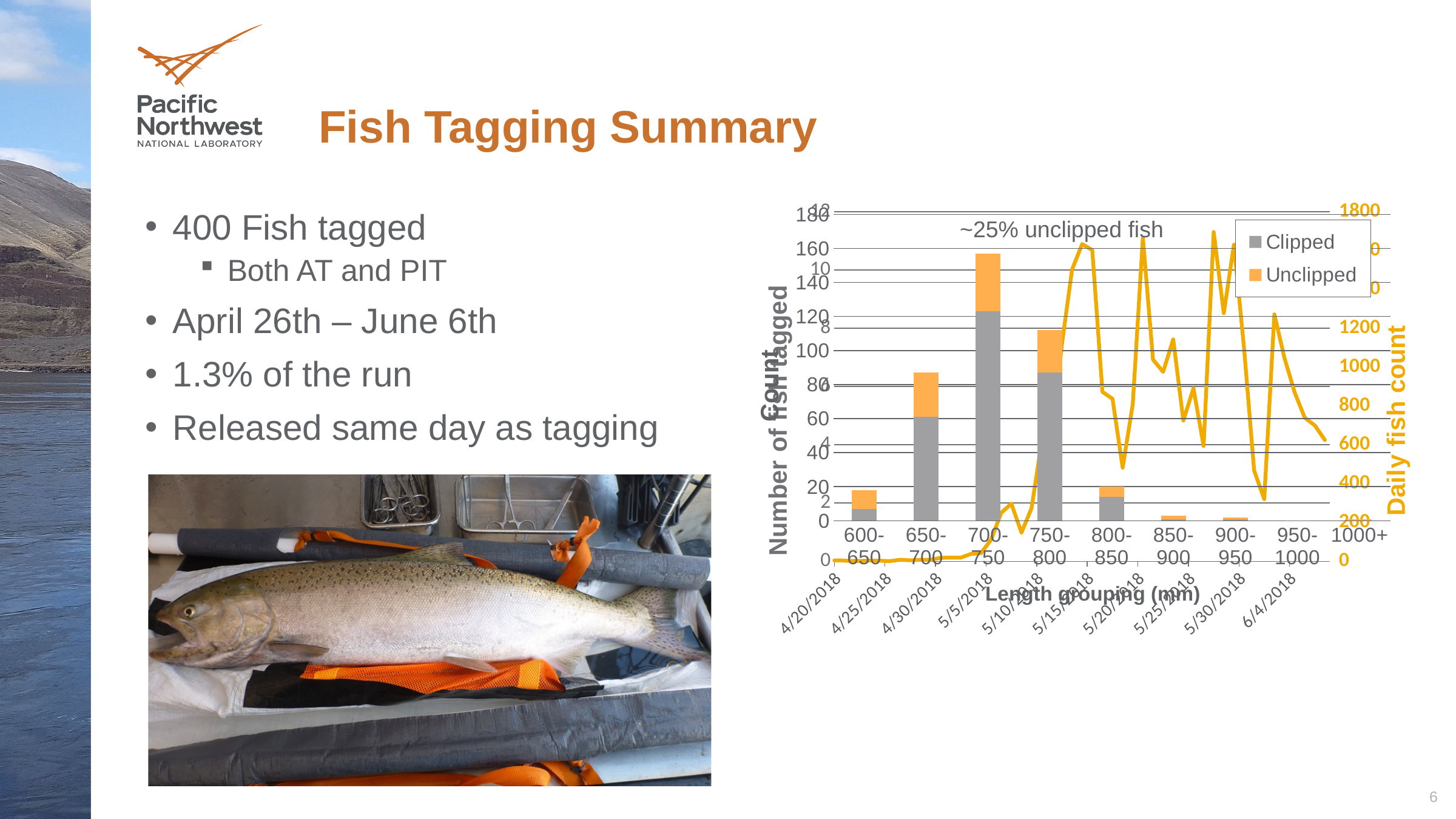
What is the title of the right-hand vertical axis used by the line chart? Daily fish count What are the two series named in the legend of the stacked bar chart? Clipped and Unclipped Is the total number of fish tagged for the 700-750 length grouping greater or less than 140? greater What kind of chart shows the daily fish count over dates from 4/20/2018 to 6/4/2018? Line chart How many length groupings are shown on the x axis of the stacked bar chart? 9 Is the total number of fish tagged for the 600-650 length grouping greater or less than 40? less Is the total number of fish tagged for the 650-700 length grouping greater or less than 100? less In the stacked bar chart, which has more fish tagged: the 650-700 grouping or the 750-800 grouping? 750-800 How many series does the legend of the stacked bar chart list? 2 In the stacked bar chart, which length grouping has the highest number of fish tagged? 700-750 What kind of chart shows the number of fish tagged by length grouping? Stacked bar chart